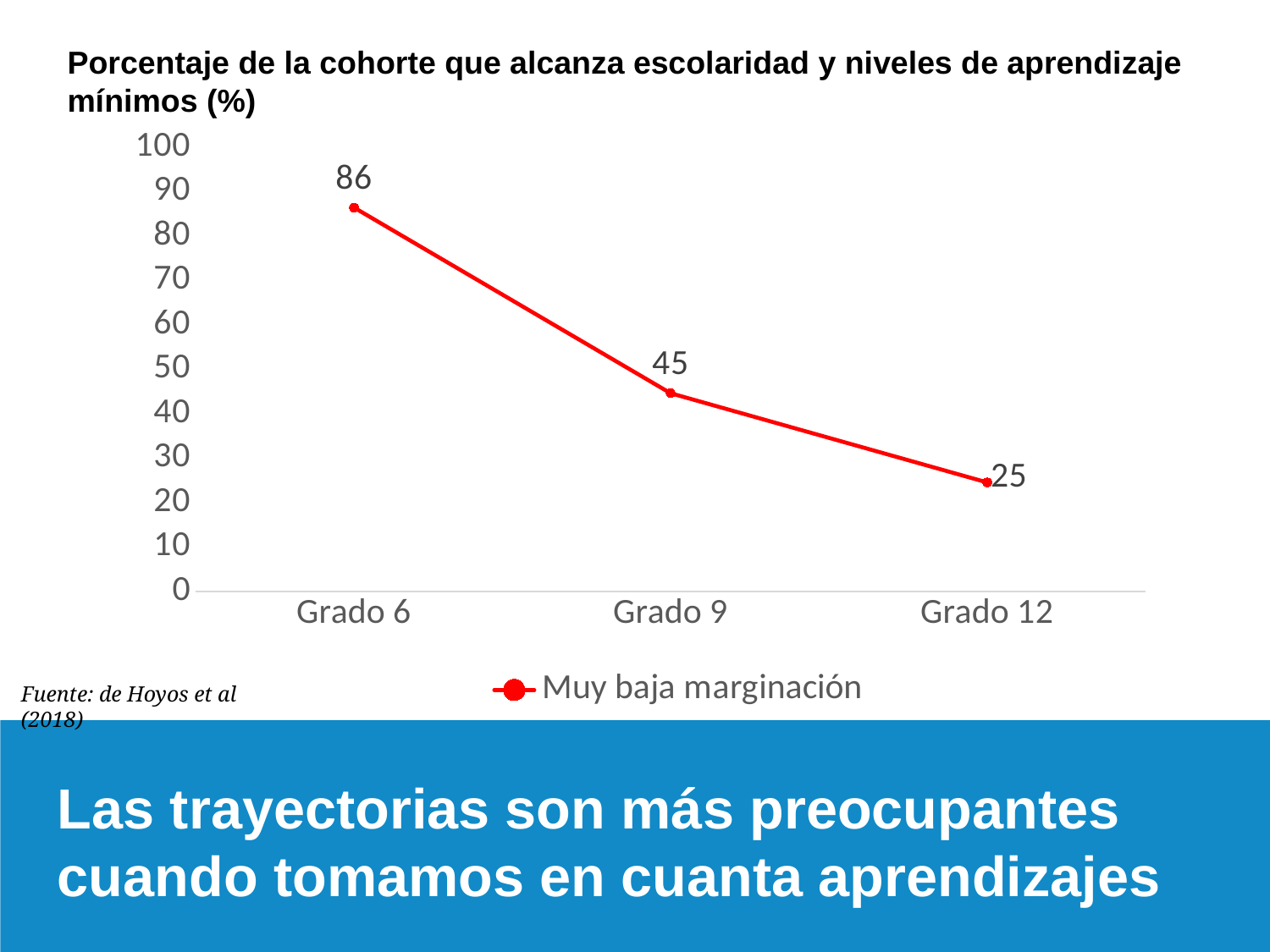
What is the value for Grado 12? 25 What is the difference between the values for Grado 9 and Grado 12? 20 Do the values rise or fall from Grado 6 to Grado 12? fall How many grades are plotted on the x axis? 3 What is the value for Grado 9? 45 Which grade has the highest value? Grado 6 Is the value for Grado 6 greater or less than 80? greater What is the difference between the values for Grado 6 and Grado 9? 41 Which is larger, the value for Grado 9 or the value for Grado 12? Grado 9 Which grade has the lowest value? Grado 12 What kind of chart is shown? line chart What is the value for Grado 6? 86